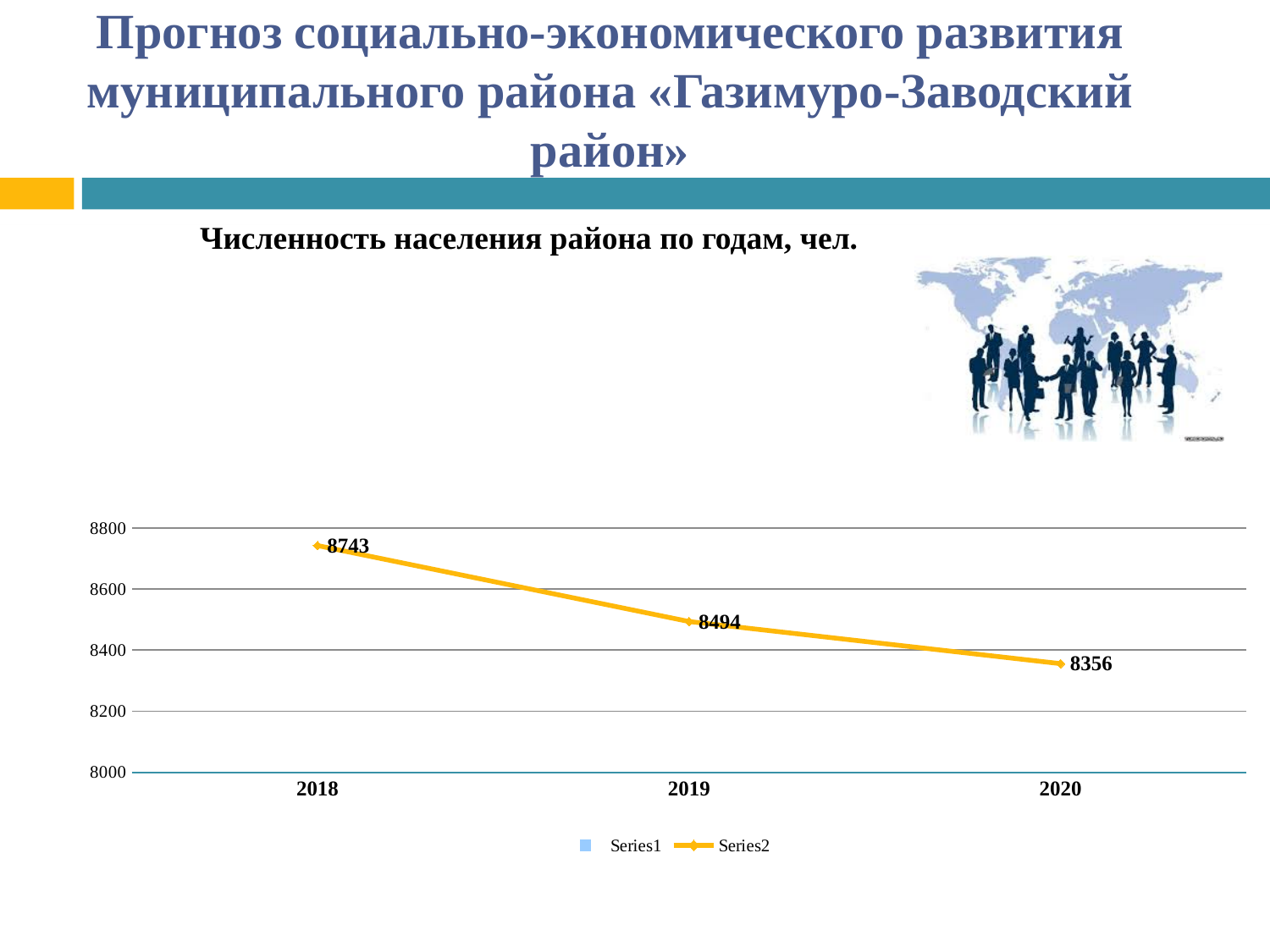
Which is larger, the value for 2018 or the value for 2020? 2018 Is the value for 2020 greater or less than 8400? less What is the population value shown for 2019? 8494 What kind of chart is shown on the slide? line chart What is the difference between the population values for 2019 and 2020? 138 What is the population value shown for 2020? 8356 What is the difference between the population values for 2018 and 2019? 249 Which year has the highest population value? 2018 How many years are plotted on the chart? 3 Which year has the lowest population value? 2020 What is the population value shown for 2018? 8743 Do the values rise or fall from 2018 to 2020? fall